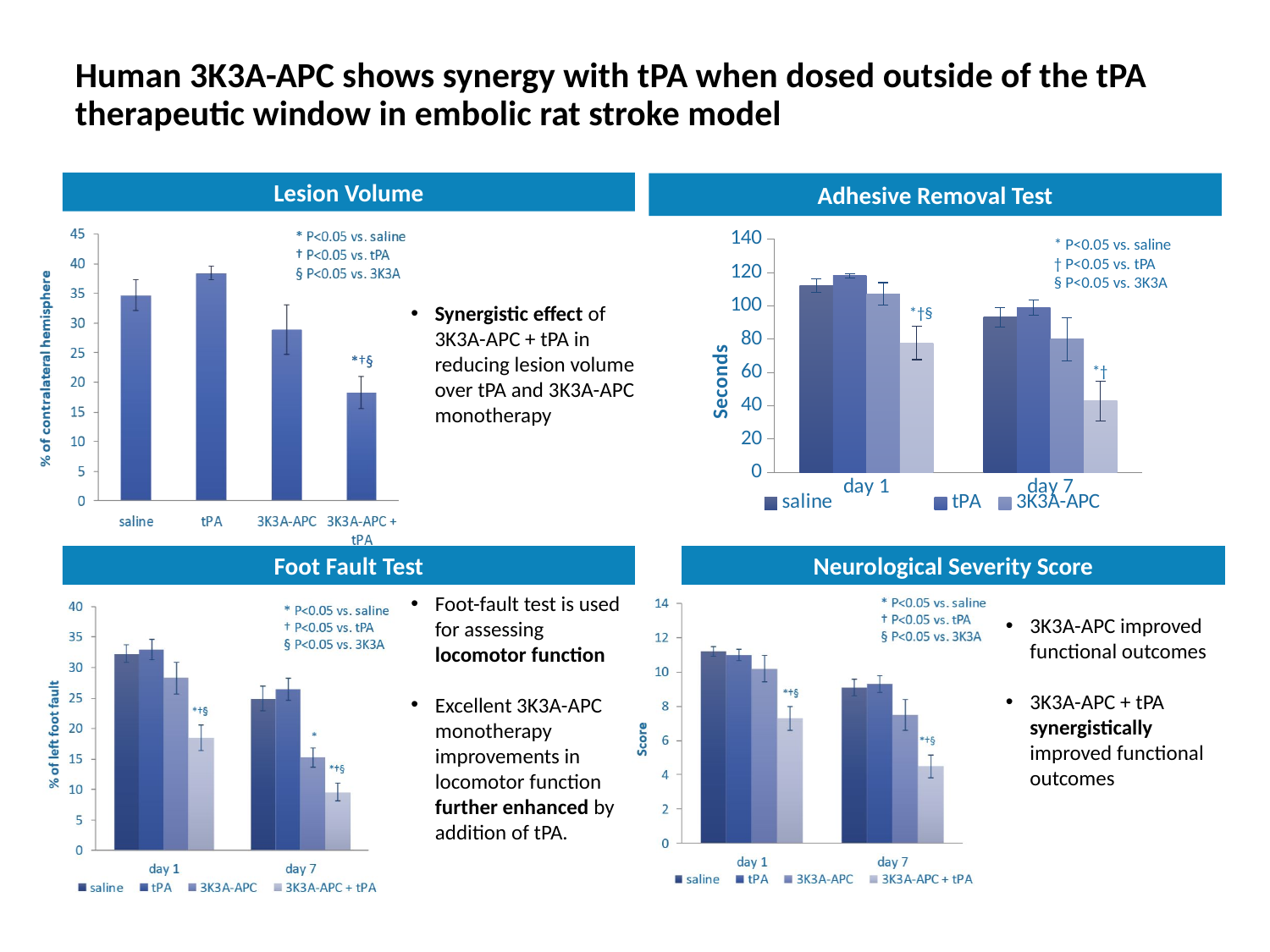
In the Adhesive Removal Test chart, is the value for 3K3A-APC + tPA at day 7 greater or less than 60? less How many series does the legend of the Foot Fault Test chart list? 4 In the Adhesive Removal Test chart, is the value for saline at day 1 greater or less than 100? greater In the Foot Fault Test chart, is the value for 3K3A-APC + tPA at day 1 greater or less than 20? less What is the y-axis label of the Adhesive Removal Test chart? Seconds In the Foot Fault Test chart, which is larger at day 7: saline or 3K3A-APC? saline In the Lesion Volume chart, which category has the highest bar? tPA In the Lesion Volume chart, which category has the lowest bar? 3K3A-APC + tPA How many categories are shown on the x axis of the Lesion Volume chart? 4 What kind of chart is the Adhesive Removal Test chart? bar chart